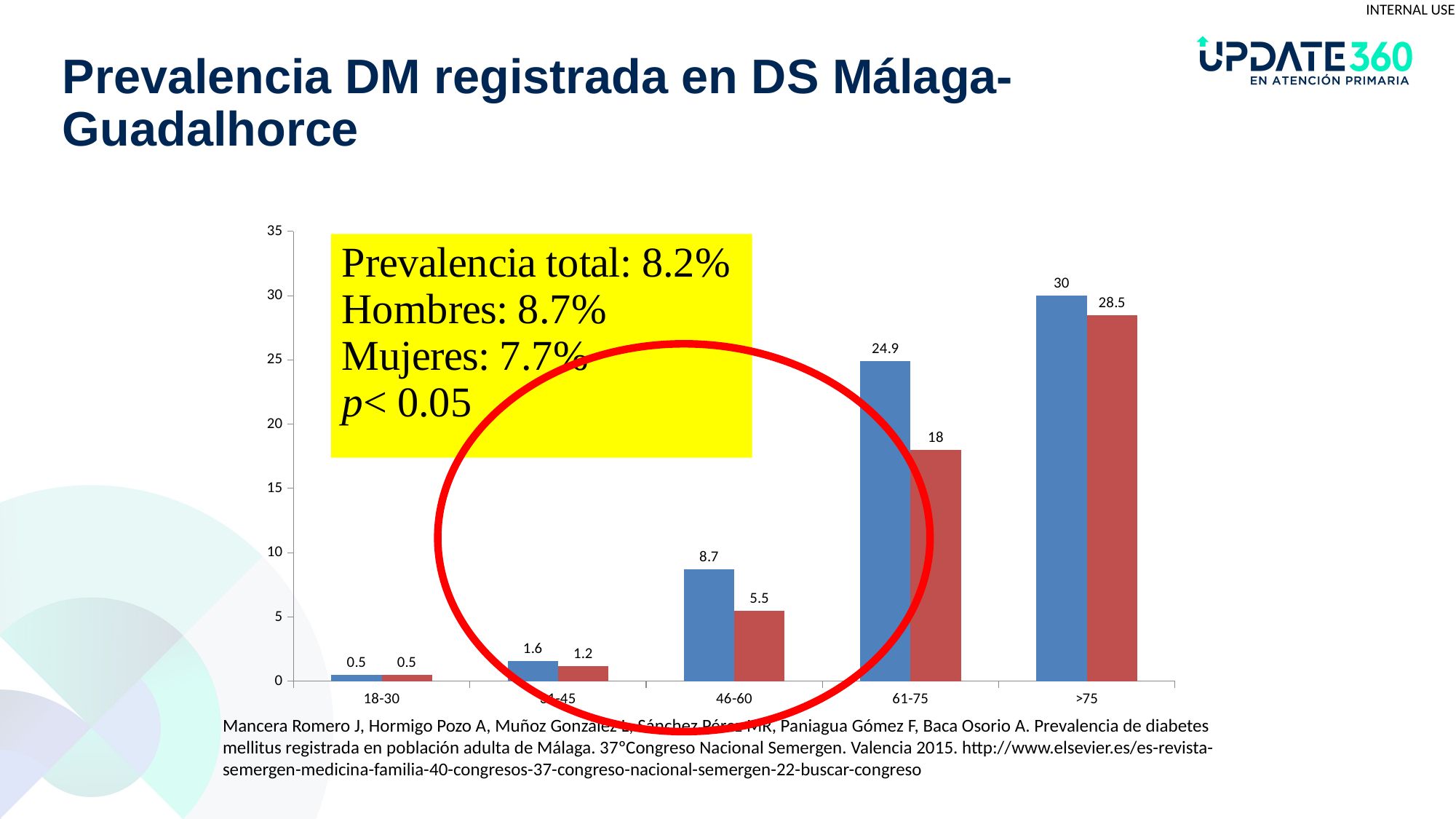
Do the blue bar values rise or fall as the age groups increase along the x axis? rise What is the difference between the blue bar for >75 and the blue bar for 61-75? 5.1 What is the value of the blue bar for the >75 age group? 30 What is the value of the blue bar for the 46-60 age group? 8.7 What is the value of the red bar for the 61-75 age group? 18 How many age groups are shown on the x axis? 5 For the 46-60 age group, which bar is larger, blue or red? blue Which age group has the highest blue bar? >75 What type of chart is shown on the slide? bar chart Which age group has the lowest red bar? 18-30 What is the value of the red bar for the 18-30 age group? 0.5 What is the difference between the blue and red bars for the 61-75 age group? 6.9